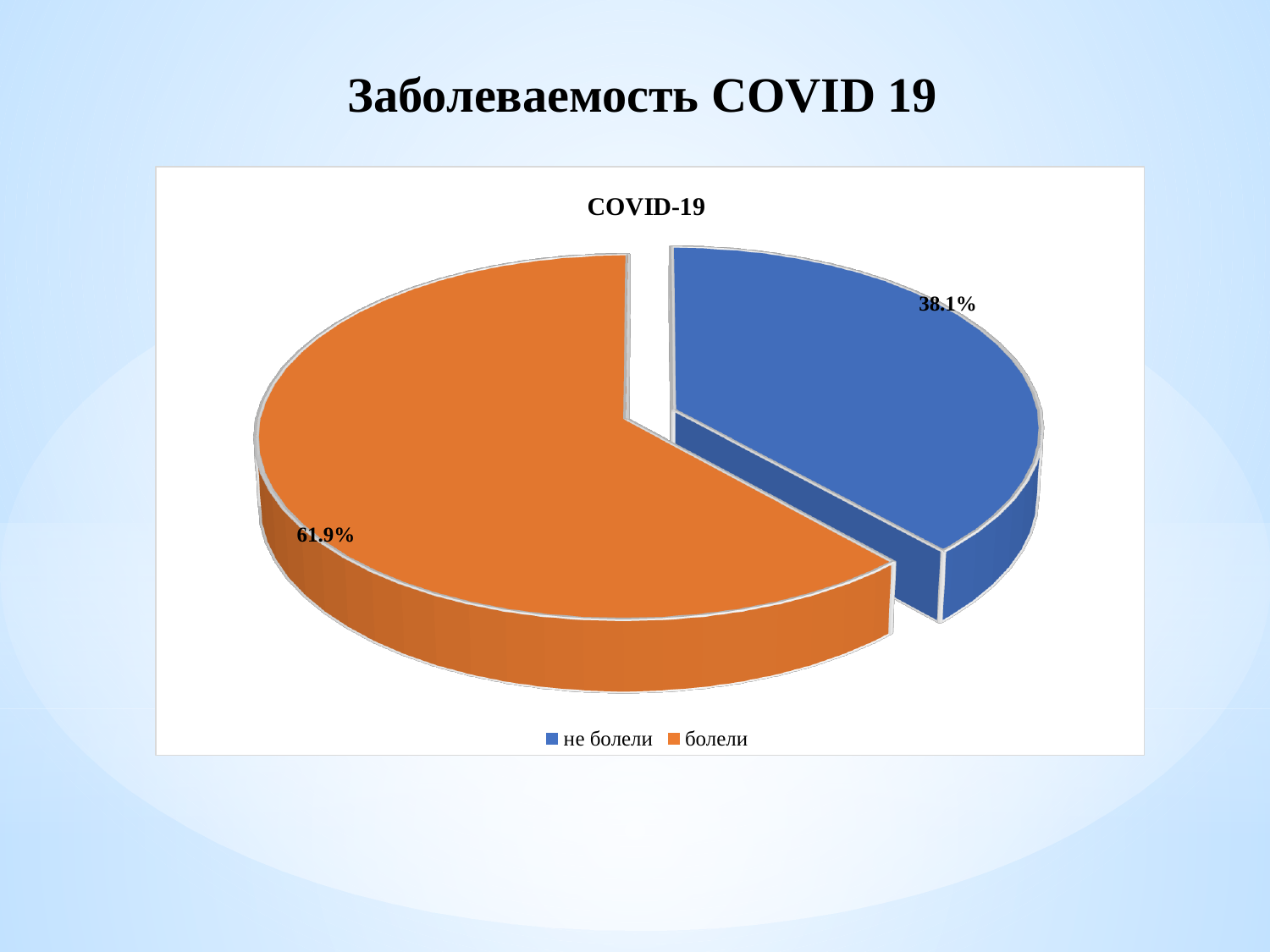
What is the difference in percentage points between the "болели" and "не болели" slices? 23.8 What is the chart's title? COVID-19 How many slices does the pie chart have? 2 Which slice is the smallest? не болели What share of the pie is labelled "болели"? 61.9% What kind of chart is shown on the slide? pie chart What share of the pie is labelled "не болели"? 38.1% Which slice is the largest? болели Which is larger, the "болели" slice or the "не болели" slice? болели How many entries does the legend list? 2 What colour is the "не болели" slice? blue